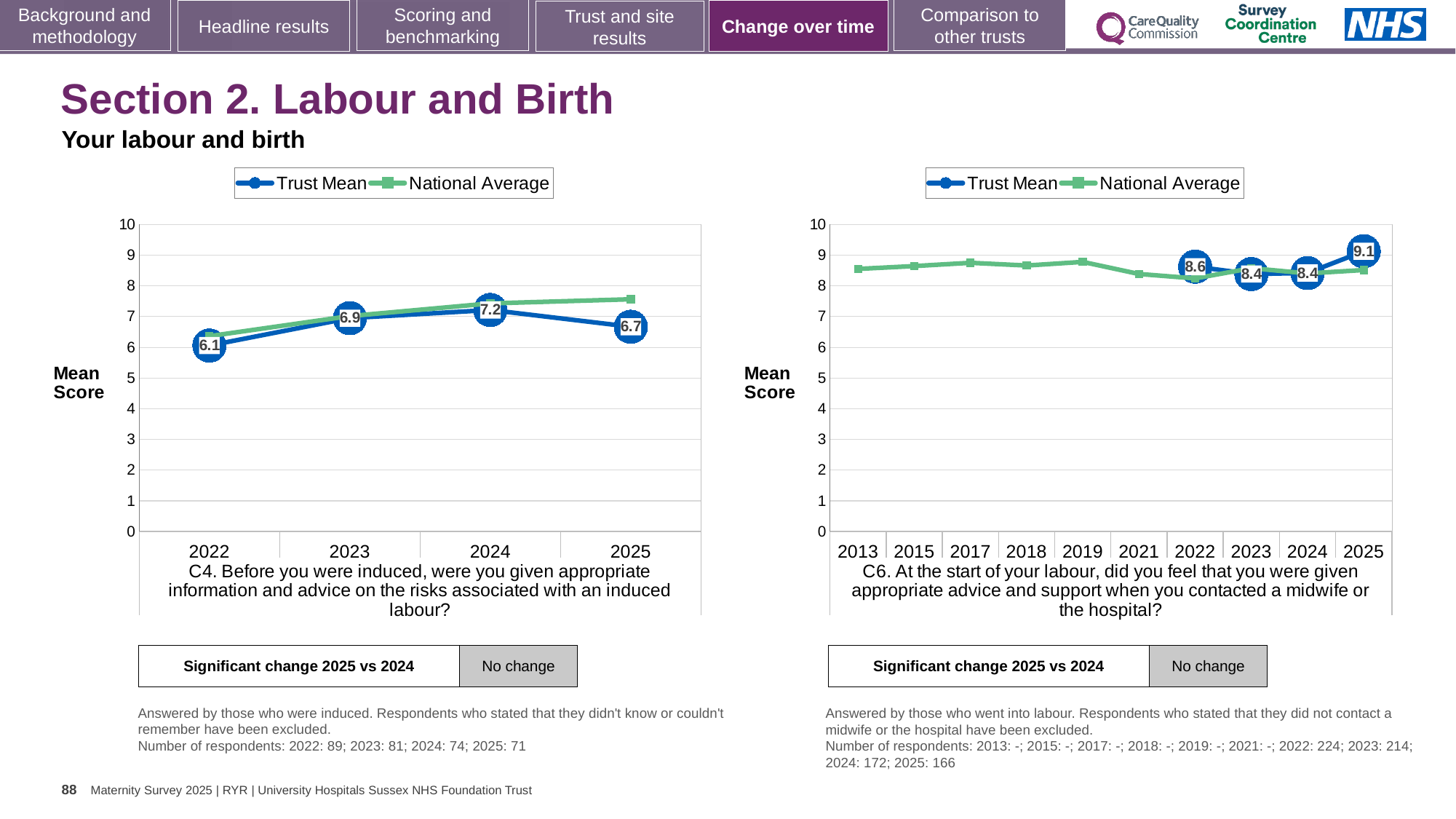
In the C4 chart on the left, what is the difference between the Trust Mean for 2024 and 2025? 0.5 In the C4 chart on the left, which year has the highest Trust Mean? 2024 In the C4 chart on the left, which year has the lowest Trust Mean? 2022 How many series does the legend of the C6 chart on the right list? 2 In the C4 chart on the left, how many years are shown on the x axis? 4 In the C6 chart on the right, what is the Trust Mean for 2025? 9.1 In the C6 chart on the right, is the National Average for 2013 greater or less than 8? greater In the C6 chart on the right, how many years are shown on the x axis? 10 In the C6 chart on the right, what is the Trust Mean for 2022? 8.6 In the C4 chart on the left, what is the Trust Mean for 2025? 6.7 In the C6 chart on the right, which year has the highest Trust Mean? 2025 In the C4 chart on the left, what is the Trust Mean for 2022? 6.1